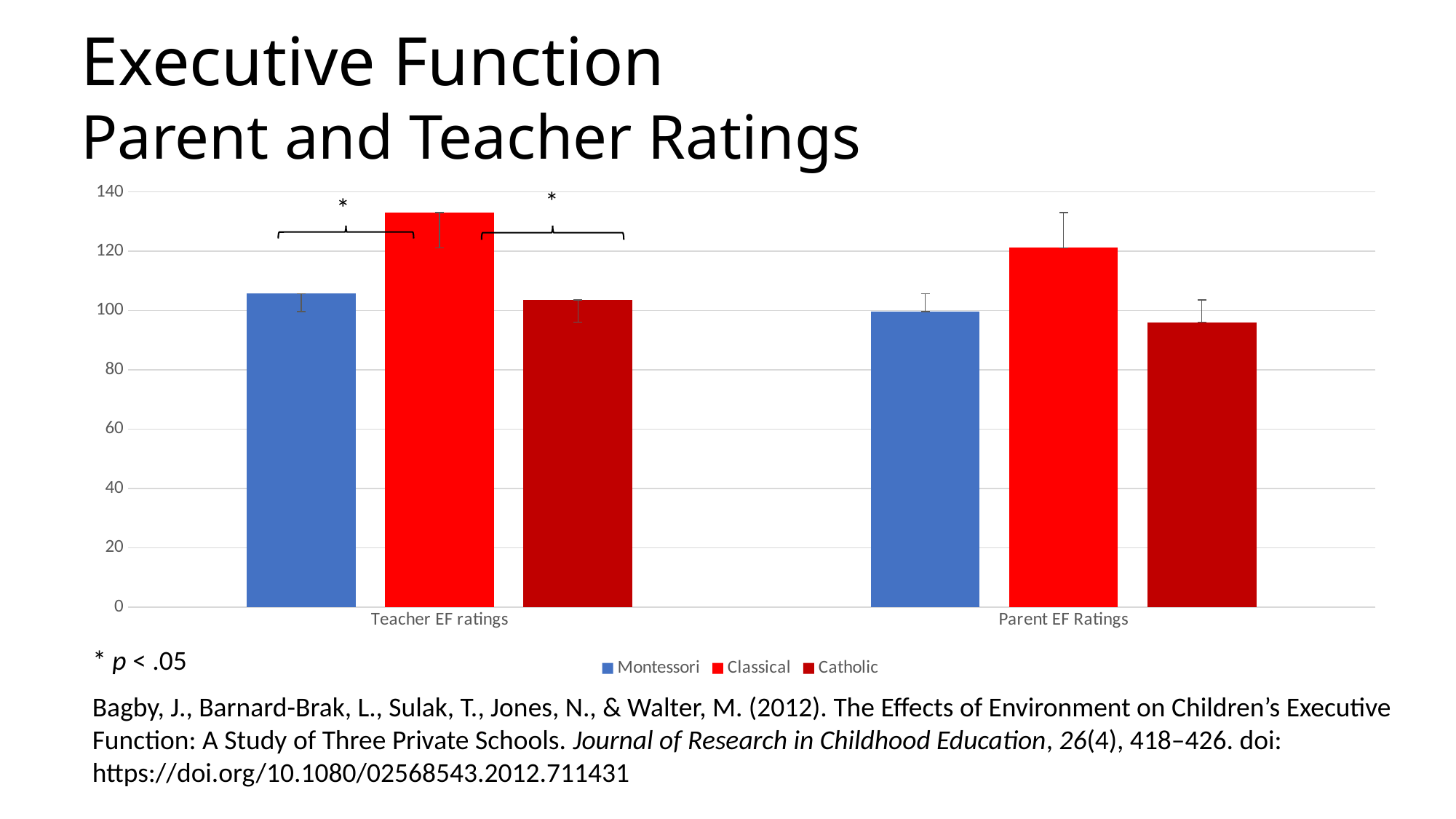
For Teacher EF ratings, which is larger: Classical or Montessori? Classical For Parent EF Ratings, which is larger: Catholic or Classical? Classical Which school type has the highest Parent EF Ratings? Classical How many categories are shown on the x axis? 2 What kind of chart is shown on the slide? bar chart Which school type has the highest Teacher EF ratings? Classical Is the Teacher EF ratings value for Montessori greater or less than 100? greater Is the Teacher EF ratings value for Classical greater or less than 120? greater Which series is shown in blue in the legend? Montessori How many series does the legend list? 3 Is the Parent EF Ratings value for Catholic greater or less than 100? less